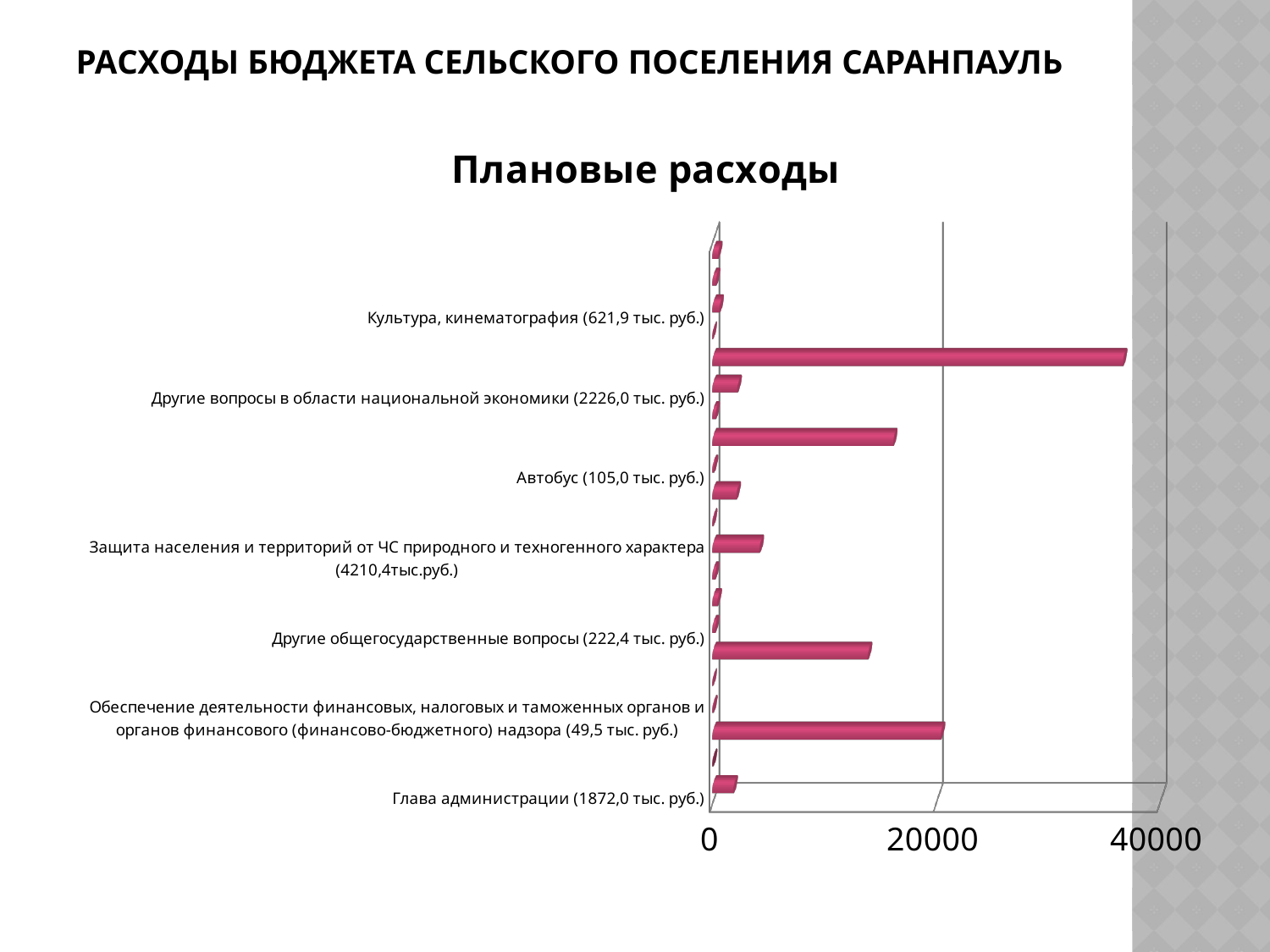
Is the value of the shortest bar in the chart greater or less than 20000? less What amount is printed in the category label for Другие общегосударственные вопросы? 222,4 тыс. руб. What type of chart is shown on the slide? bar chart What amount is printed in the category label for Автобус? 105,0 тыс. руб. Which printed label amount is larger: Глава администрации or Автобус? Глава администрации What amount is printed in the category label for Защита населения и территорий от ЧС природного и техногенного характера? 4210,4тыс.руб. Is the value of the longest bar in the chart greater or less than 20000? greater What is the title of the chart? Плановые расходы What amount is printed in the category label for Другие вопросы в области национальной экономики? 2226,0 тыс. руб. What is the largest value shown on the horizontal axis of the chart? 40000 What amount is printed in the category label for Культура, кинематография? 621,9 тыс. руб. What amount is printed in the category label for Глава администрации? 1872,0 тыс. руб.